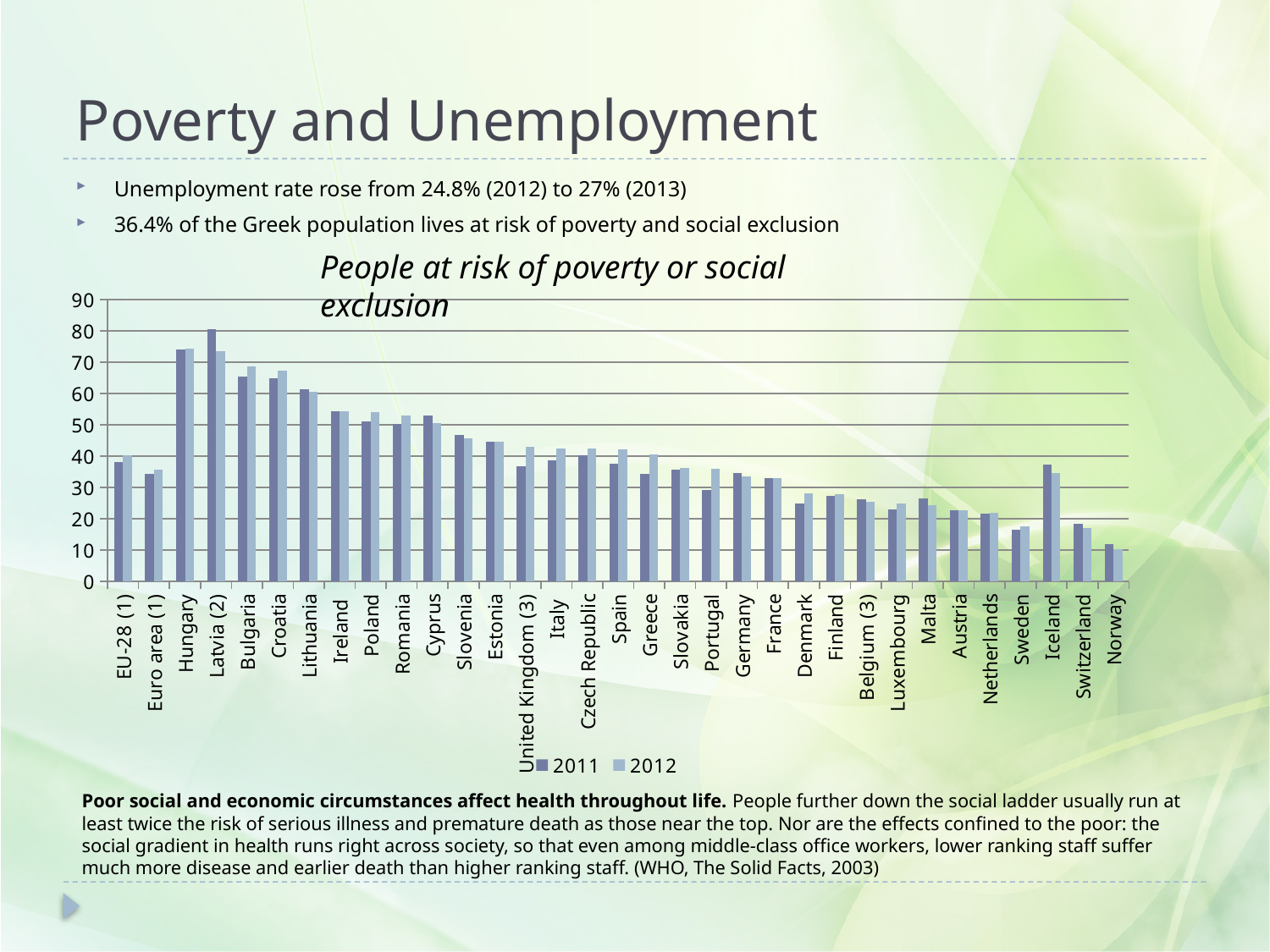
Which category has the lowest 2011 value? Norway Is the 2011 value for Hungary greater or less than 70? greater How many series does the chart legend list? 2 What are the two series named in the chart legend? 2011 and 2012 Which has the larger 2011 value, Iceland or Sweden? Iceland How many categories are shown along the x axis of the chart? 33 What kind of chart is shown on the slide? bar chart Is the 2011 value for Sweden greater or less than 20? less Which is larger for Greece, the 2011 value or the 2012 value? 2012 Which category has the highest 2011 value? Latvia (2) What is the title of the chart? People at risk of poverty or social exclusion